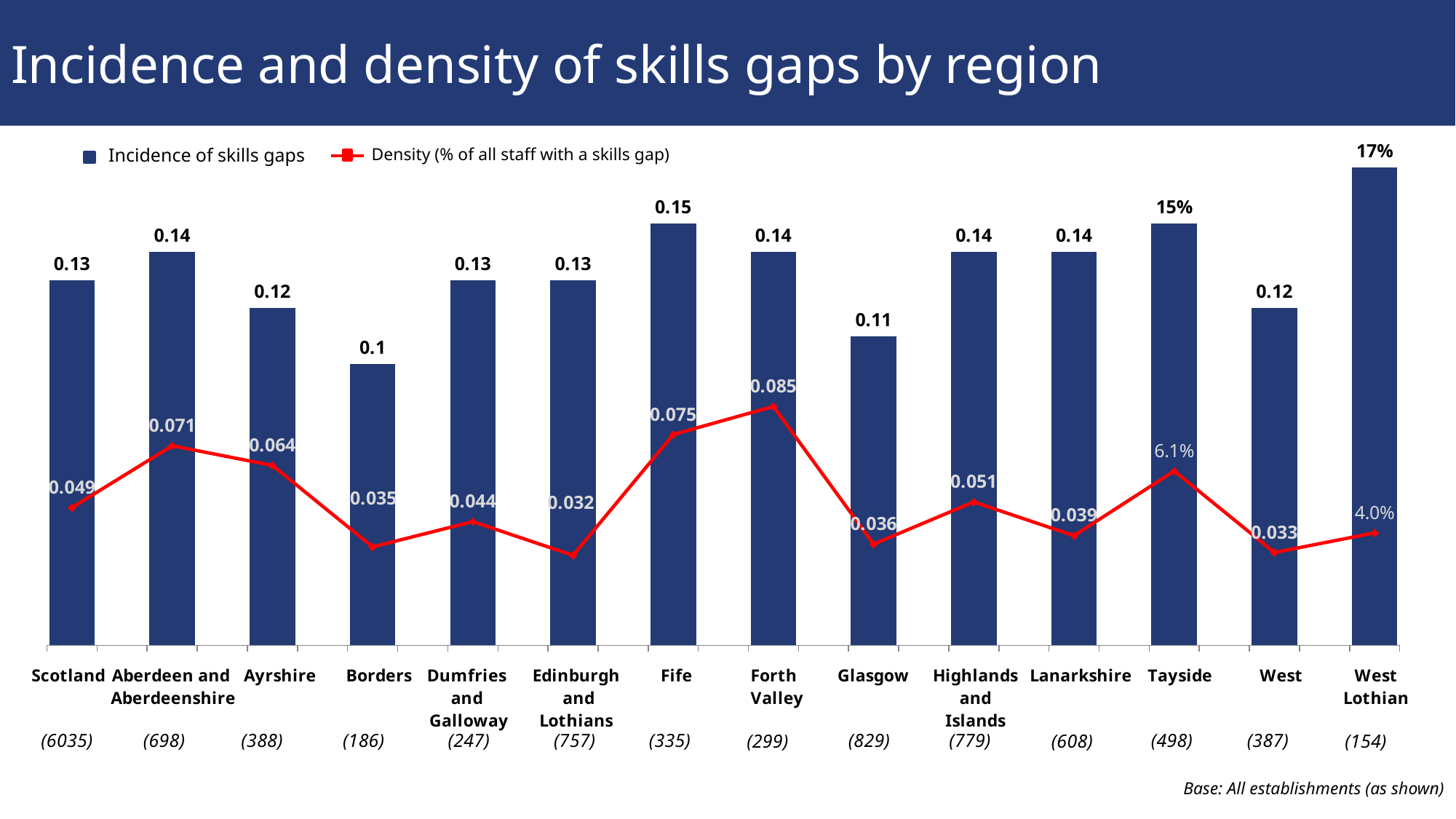
Which region has the highest incidence of skills gaps? West Lothian What is the difference between the density values for Aberdeen and Aberdeenshire and Borders? 0.036 Which region has the lowest incidence of skills gaps? Borders What kind of chart is this? Combined bar and line chart What is the density value shown for Tayside? 6.1% How many regions are shown on the x axis? 14 What is the density (% of all staff with a skills gap) for Forth Valley? 0.085 What is the incidence of skills gaps for Fife? 0.15 Which has a higher density of skills gaps, Glasgow or Highlands and Islands? Highlands and Islands Which region has the lowest density of skills gaps? Edinburgh and Lothians How many series does the legend list? 2 Which region has the highest density of skills gaps? Forth Valley